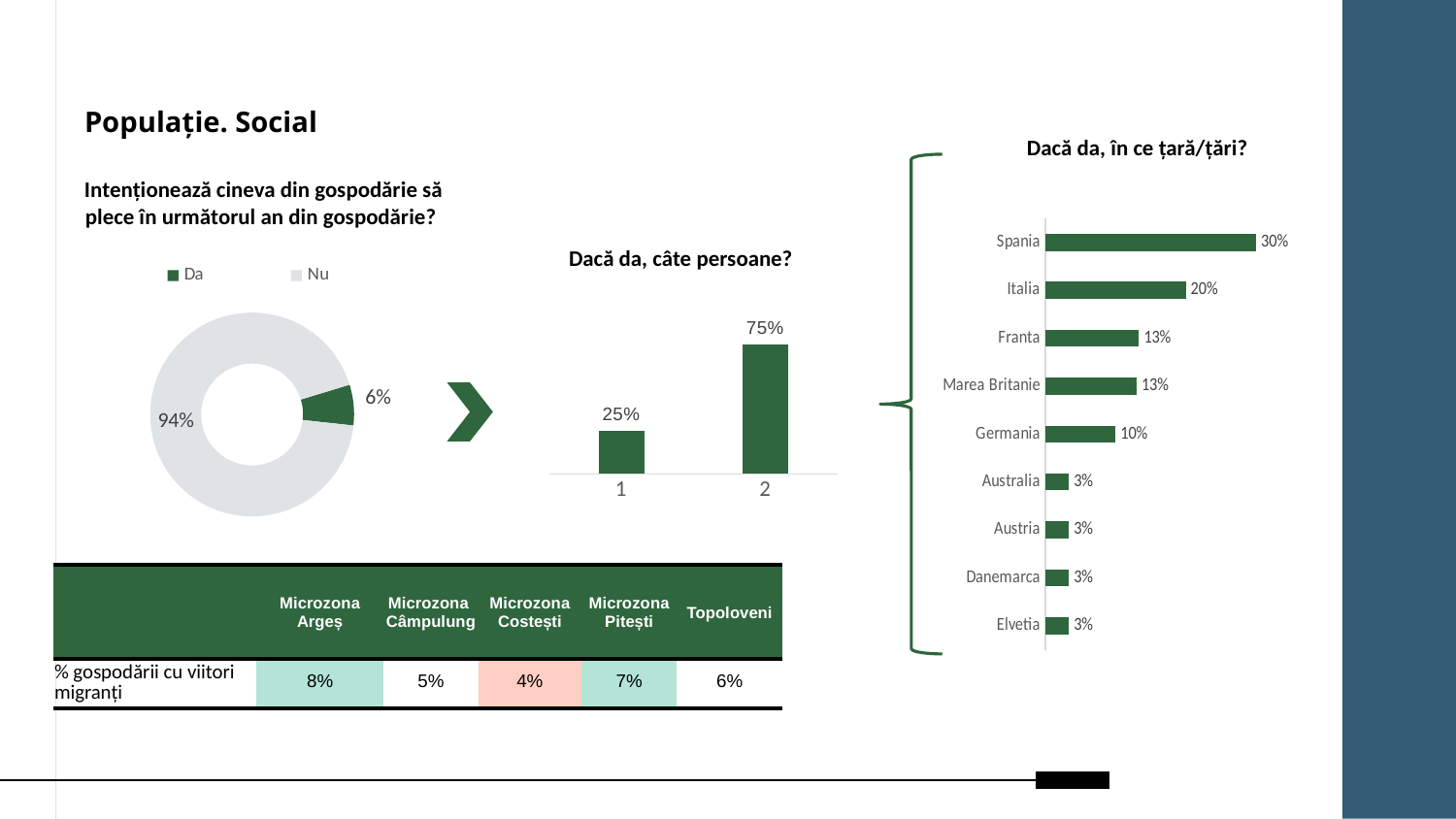
In the chart 'Dacă da, în ce țară/țări?', what is the value for Elvetia? 3% In the chart 'Dacă da, în ce țară/țări?', which is larger, Franta or Germania? Franta In the donut chart 'Intenționează cineva din gospodărie să plece în următorul an din gospodărie?', what share is 'Da'? 6% In the chart 'Dacă da, în ce țară/țări?', what is the value for Italia? 20% In the chart 'Dacă da, în ce țară/țări?', how many countries are listed? 9 What kind of chart is 'Dacă da, câte persoane?'? bar chart In the chart 'Dacă da, în ce țară/țări?', which country has the highest value? Spania In the chart 'Dacă da, câte persoane?', what is the value for category 2? 75% In the donut chart 'Intenționează cineva din gospodărie să plece în următorul an din gospodărie?', what share is 'Nu'? 94% In the chart 'Dacă da, în ce țară/țări?', what is the difference between Spania and Germania? 20% How many series does the legend of the donut chart 'Intenționează cineva din gospodărie să plece...' list? 2 In the chart 'Dacă da, câte persoane?', what is the difference between the values for 2 and 1? 50%